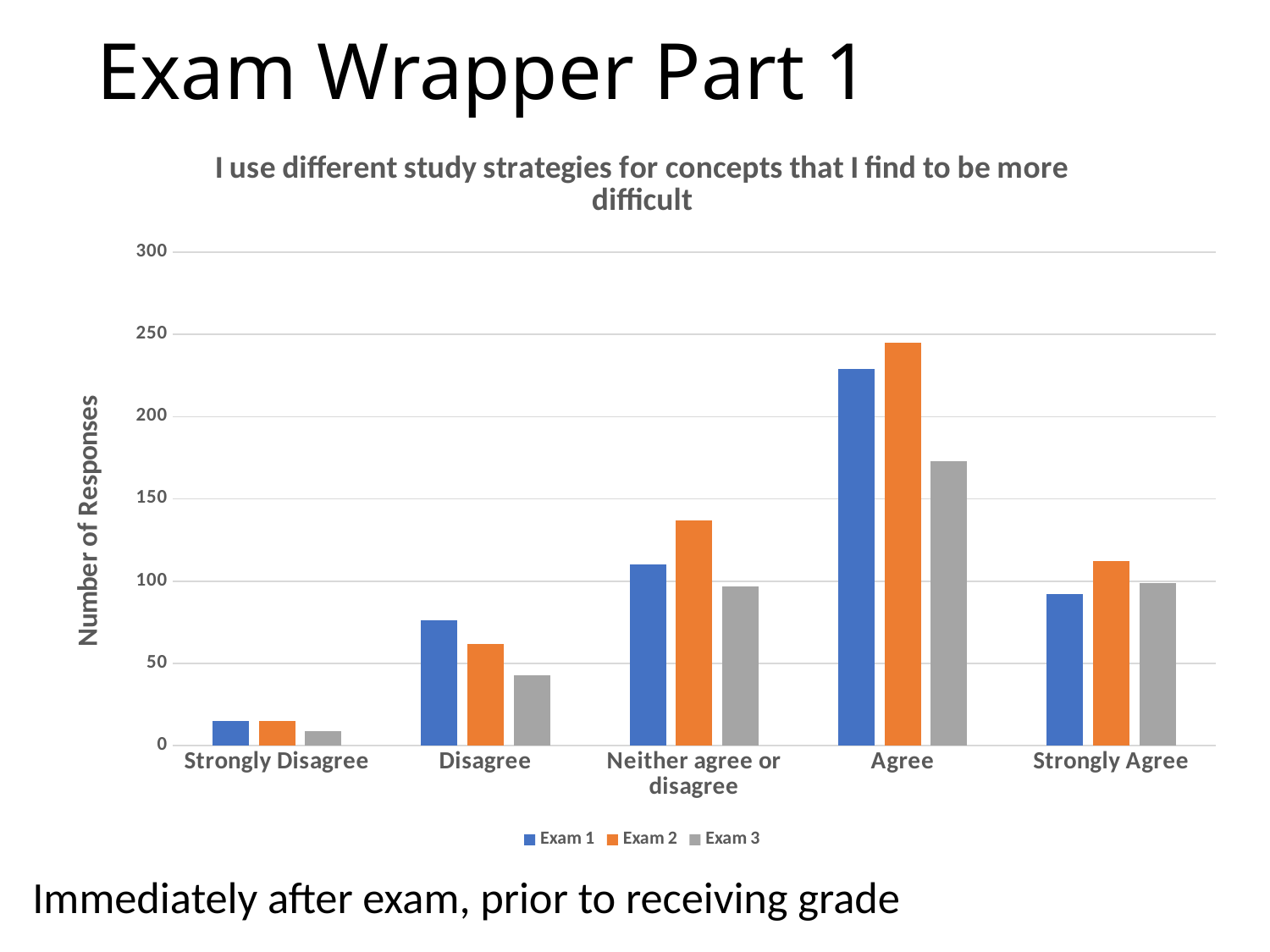
Is the Exam 2 value for Agree greater or less than 200? greater Is the Exam 3 value for Agree greater or less than 150? greater What kind of chart is shown on the slide? bar chart What is the label on the y axis of the chart? Number of Responses For Exam 3, which response category has the lowest number of responses? Strongly Disagree For the Agree category, which is larger: Exam 1 or Exam 3? Exam 1 For the Neither agree or disagree category, which is larger: Exam 1 or Exam 2? Exam 2 For Exam 2, which response category has the highest number of responses? Agree Is the Exam 1 value for Disagree greater or less than 100? less How many response categories are shown on the x axis? 5 What is the title of the chart? I use different study strategies for concepts that I find to be more difficult How many series does the legend list? 3